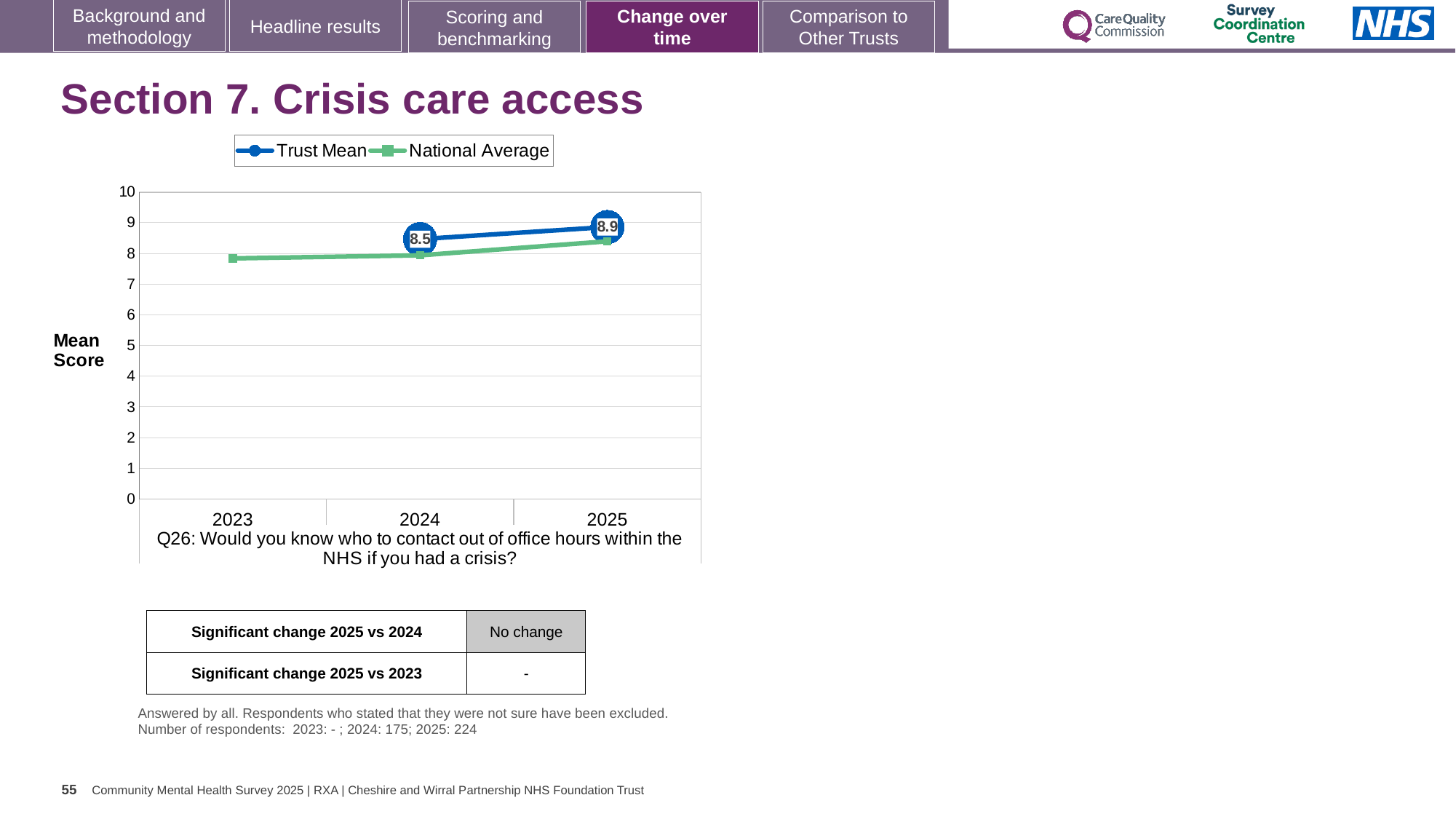
Which is larger in 2025, the Trust Mean or the National Average? Trust Mean Is the National Average value for 2025 greater or less than 7? greater By how much did the Trust Mean change from 2024 to 2025? 0.4 In which year is the Trust Mean highest? 2025 How many years are shown on the x axis? 3 What is the Trust Mean value for 2024? 8.5 What is the label on the y axis of the chart? Mean Score What kind of chart is shown on the slide? line chart Is the National Average value for 2023 greater or less than 9? less How many series does the legend list? 2 What is the Trust Mean value for 2025? 8.9 Does the Trust Mean rise or fall from 2024 to 2025? rise